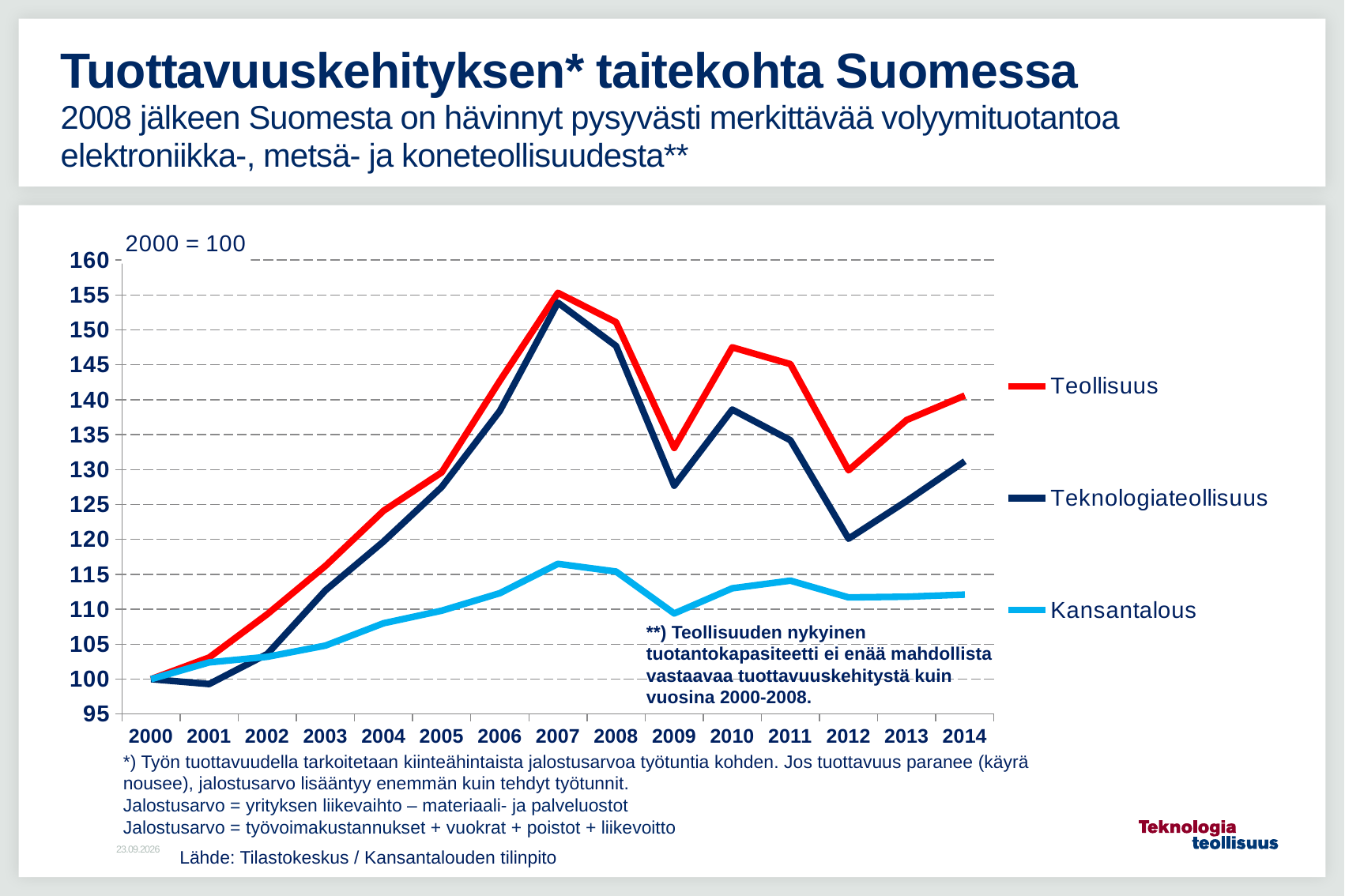
How many years are shown on the x axis? 15 Is the value for Kansantalous in 2014 greater or less than 115? less Which series has the higher value in 2012, Teollisuus or Teknologiateollisuus? Teollisuus What is the index value of all series in 2000? 100 Is the value for Teknologiateollisuus in 2009 greater or less than 125? greater What kind of chart is shown on the slide? line chart In which year is the Teknologiateollisuus series at its lowest? 2001 How many series does the legend list? 3 Does the Teknologiateollisuus series rise or fall from 2010 to 2012? fall In which year does the Teollisuus series reach its highest value? 2007 Is the value for Teollisuus in 2007 greater or less than 150? greater In which year does the Kansantalous series reach its highest value? 2007